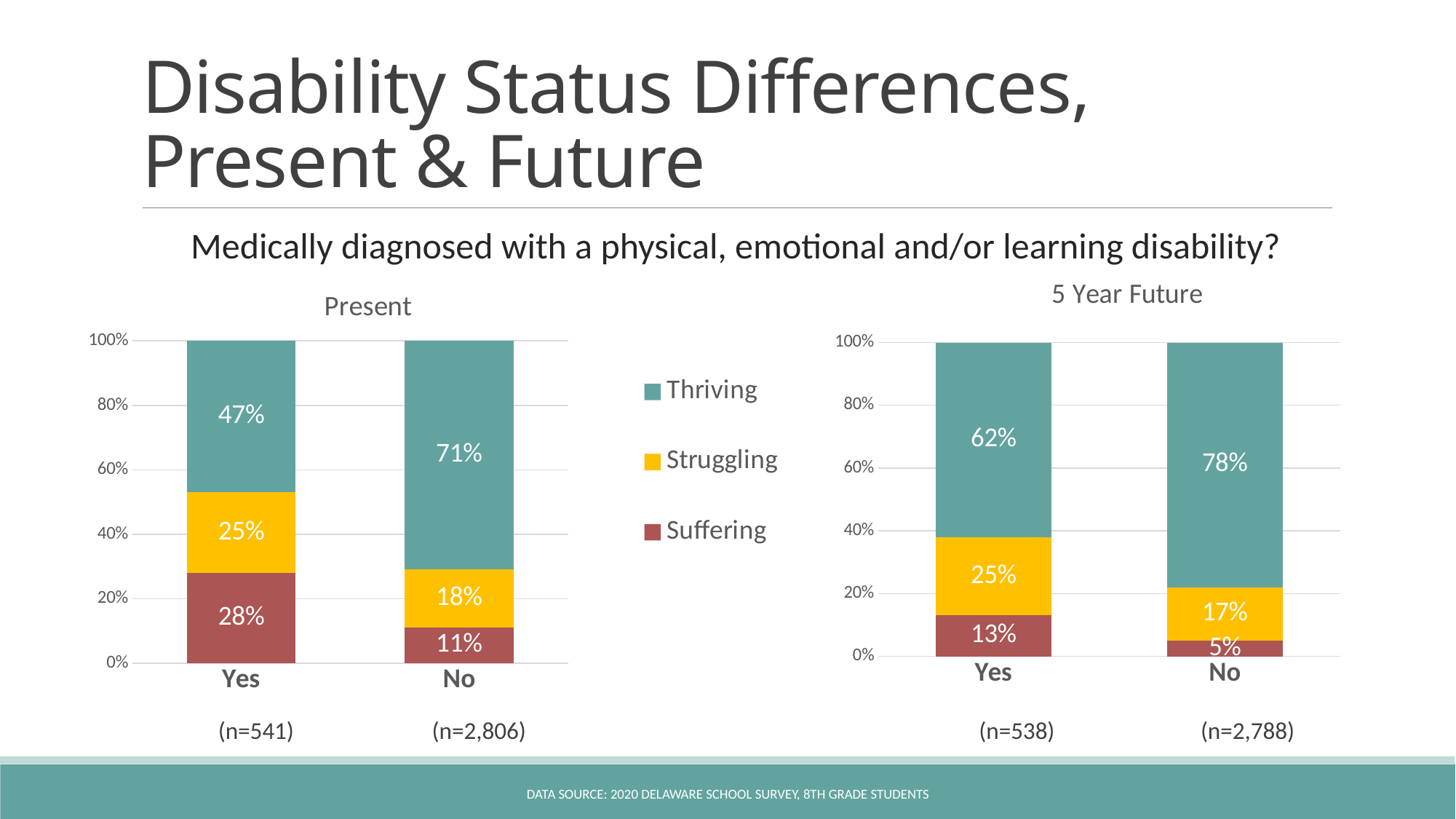
In the Present chart, what percentage of the No group is Suffering? 11% In the 5 Year Future chart, which group has the higher Thriving percentage, Yes or No? No How many series does the legend list? 3 In the Present chart, which group has the higher Suffering percentage, Yes or No? Yes In the Present chart, what percentage of the Yes group is Thriving? 47% In the 5 Year Future chart, what percentage of the Yes group is Struggling? 25% In the Present chart, which segment of the Yes bar is the largest? Thriving In the 5 Year Future chart, which segment of the No bar is the smallest? Suffering In the 5 Year Future chart, what percentage of the No group is Thriving? 78% What kind of chart is the Present chart? Stacked bar chart In the 5 Year Future chart, what is the difference between the Suffering percentages for the Yes and No groups? 8% In the Present chart, what is the difference between the Thriving percentages for the No and Yes groups? 24%